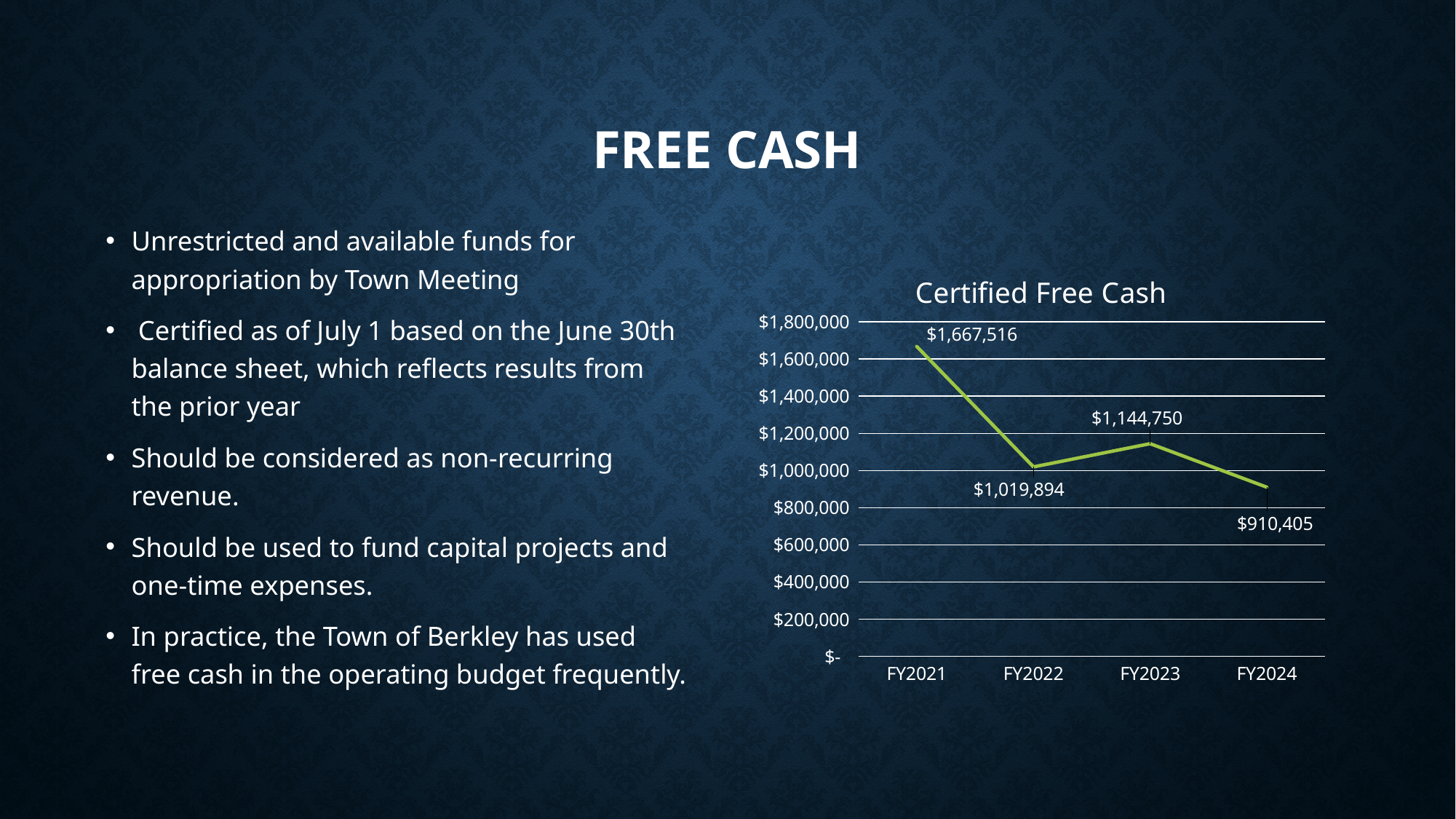
What is the certified free cash value for FY2024? $910,405 How many fiscal years are plotted in the chart? 4 What is the certified free cash value for FY2022? $1,019,894 What is the difference between the certified free cash in FY2023 and FY2024? $234,345 Which is larger, the certified free cash for FY2022 or FY2023? FY2023 Which fiscal year has the lowest certified free cash? FY2024 What is the certified free cash value for FY2021? $1,667,516 Which fiscal year has the highest certified free cash? FY2021 What is the certified free cash value for FY2023? $1,144,750 What is the title of the chart? Certified Free Cash What is the difference between the certified free cash in FY2021 and FY2022? $647,622 What kind of chart is shown on the slide? Line chart